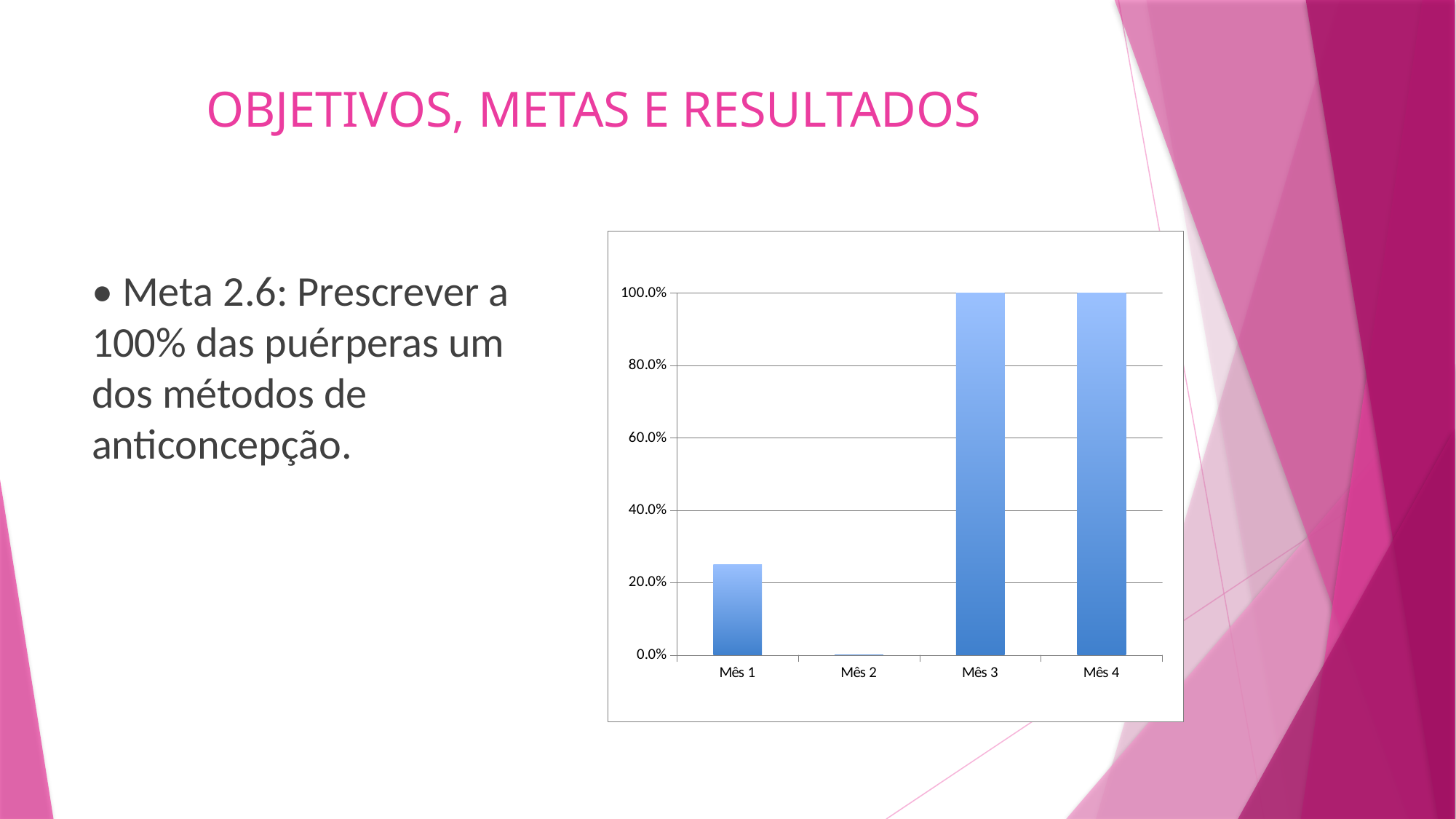
Which is larger, the value for Mês 2 or the value for Mês 4? Mês 4 Is the value for Mês 1 greater or less than 20.0%? greater Which category has the lowest value? Mês 2 What colour are the bars in the chart? blue Which is larger, the value for Mês 1 or the value for Mês 3? Mês 3 What is the value for Mês 3? 100.0% Is the value for Mês 2 greater or less than 20.0%? less Is the value for Mês 1 greater or less than 40.0%? less How many categories are shown on the x axis of the chart? 4 What is the value for Mês 4? 100.0% What kind of chart is shown on the slide? bar chart What is the highest value shown on the y axis of the chart? 100.0%